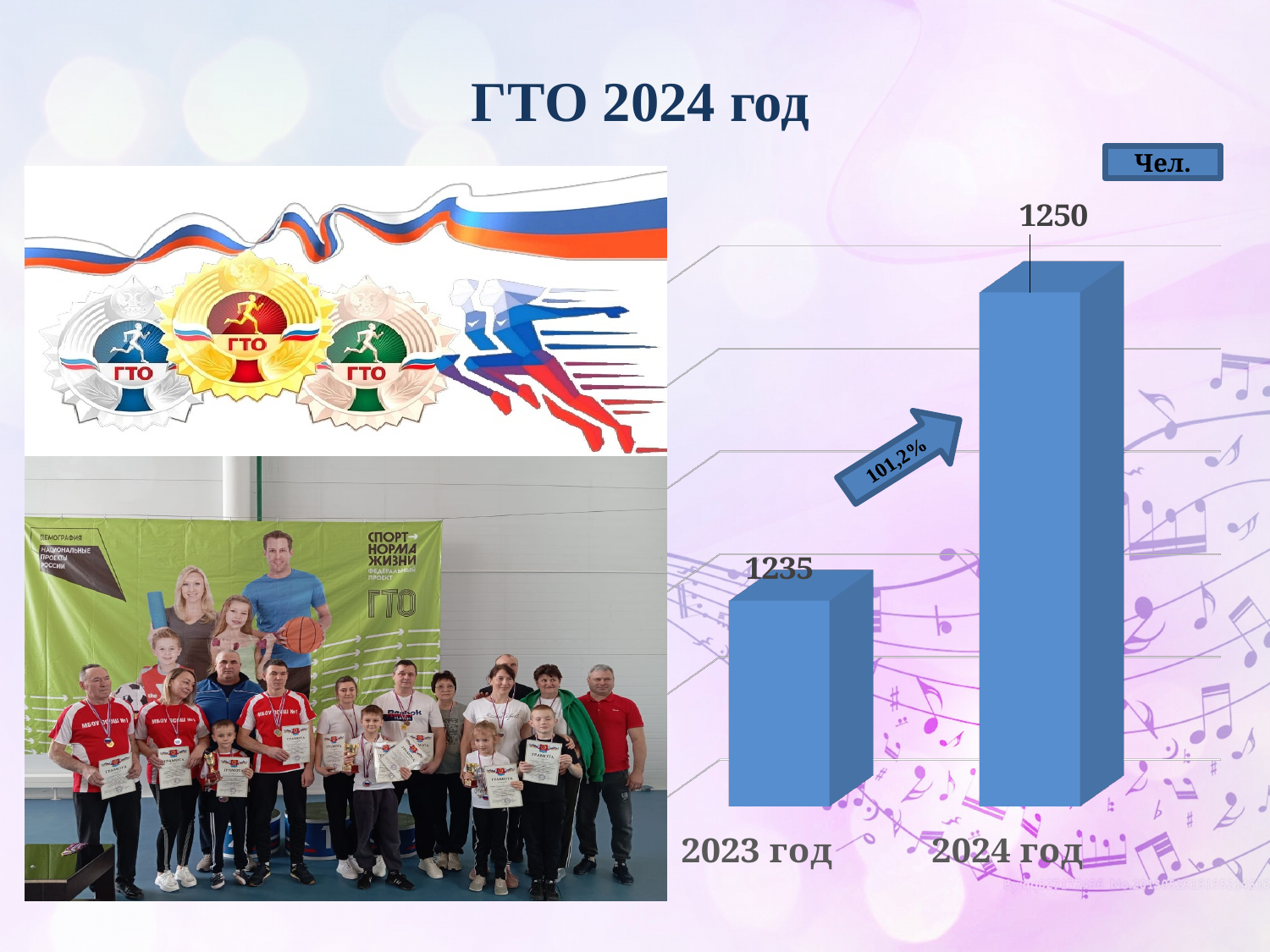
What kind of chart is shown on the slide? bar chart What label is shown in the legend box above the chart? Чел. What is the difference between the values for 2024 год and 2023 год? 15 What is the value for 2023 год? 1235 What is the total of the two bar values? 2485 Which year has the higher value? 2024 год Which year has the lower value? 2023 год What is the value for 2024 год? 1250 What percentage is written on the arrow between the two bars? 101,2% Do the values rise or fall from 2023 год to 2024 год? rise How many bars are plotted in the chart? 2 Is the value for 2024 год larger or smaller than the value for 2023 год? larger